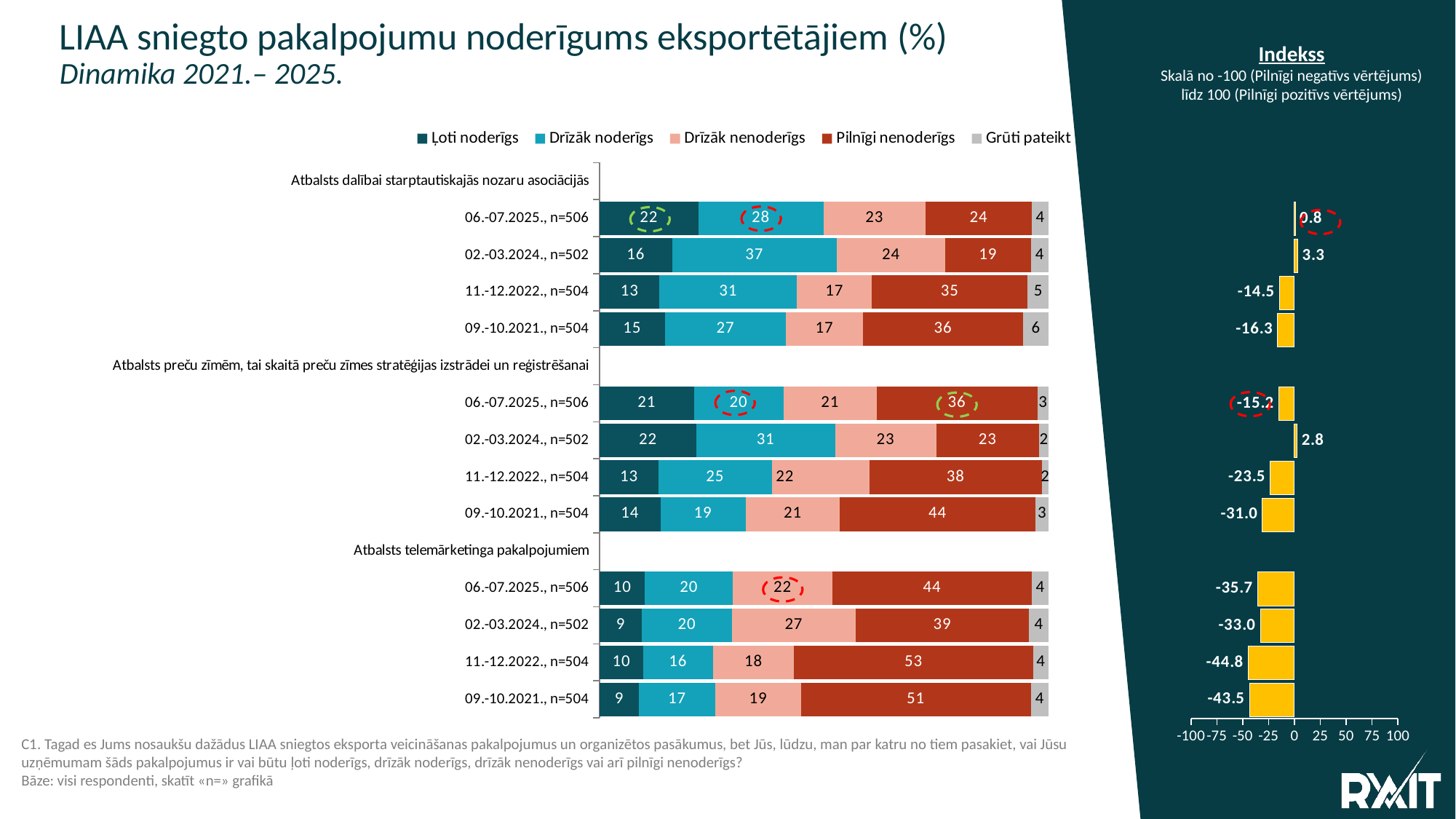
In the stacked bar chart, what is the difference in "Pilnīgi nenoderīgs" for Atbalsts telemārketinga pakalpojumiem between 06.-07.2025. and 02.-03.2024.? 5 How many bars are shown in the Indekss chart? 12 In the Indekss chart, is the value for Atbalsts preču zīmēm in 11.-12.2022. greater or less than -25? greater What kind of chart is the chart on the left of the slide? Stacked bar chart In the stacked bar chart, what is the total of the printed values for Atbalsts telemārketinga pakalpojumiem in 09.-10.2021., n=504? 100 In the Indekss chart, which bar has the highest index value? Atbalsts dalībai starptautiskajās nozaru asociācijās, 02.-03.2024., n=502 (3.3) In the Indekss chart, what is the index value for Atbalsts preču zīmēm in 09.-10.2021., n=504? -31.0 In the stacked bar chart, how many series does the legend list? 5 In the stacked bar chart, for Atbalsts dalībai starptautiskajās nozaru asociācijās, which wave has the larger "Drīzāk noderīgs" value: 02.-03.2024. or 06.-07.2025.? 02.-03.2024. In the stacked bar chart, what is the value for "Pilnīgi nenoderīgs" for Atbalsts telemārketinga pakalpojumiem in 11.-12.2022., n=504? 53 In the stacked bar chart, what is the value for "Ļoti noderīgs" for Atbalsts dalībai starptautiskajās nozaru asociācijās in 06.-07.2025., n=506? 22 In the Indekss chart, which bar has the lowest index value? Atbalsts telemārketinga pakalpojumiem, 11.-12.2022., n=504 (-44.8)